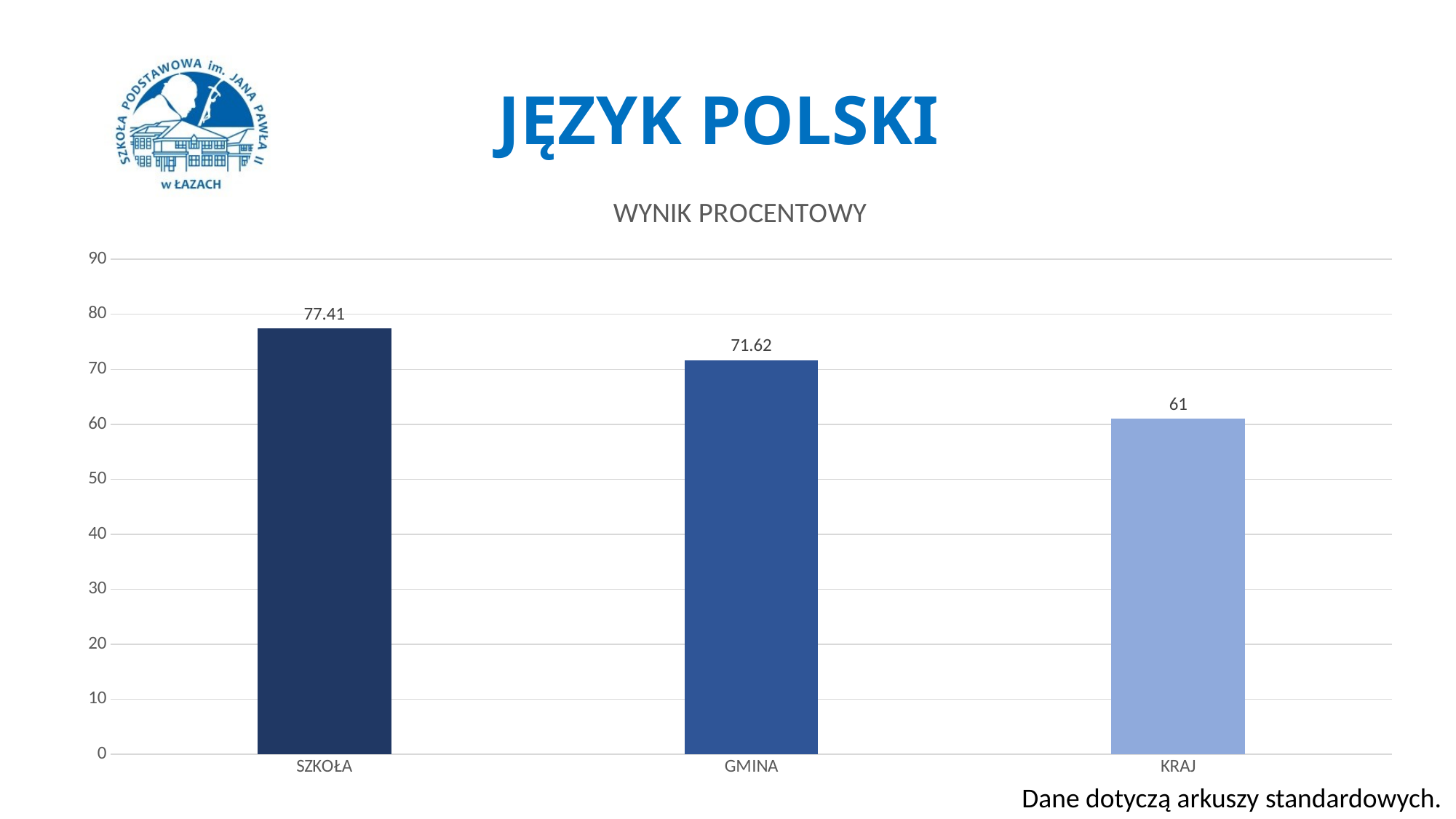
Is the value for GMINA greater or less than 70? greater What is the difference between the values for SZKOŁA and KRAJ? 16.41 What is the title of the chart? WYNIK PROCENTOWY Which category has the highest value? SZKOŁA What is the value for KRAJ? 61 Which is larger, the value for GMINA or the value for KRAJ? GMINA What is the value for GMINA? 71.62 What is the value for SZKOŁA? 77.41 What kind of chart is shown on the slide? bar chart Which category has the lowest value? KRAJ How many categories are shown in the chart? 3 What is the difference between the values for SZKOŁA and GMINA? 5.79